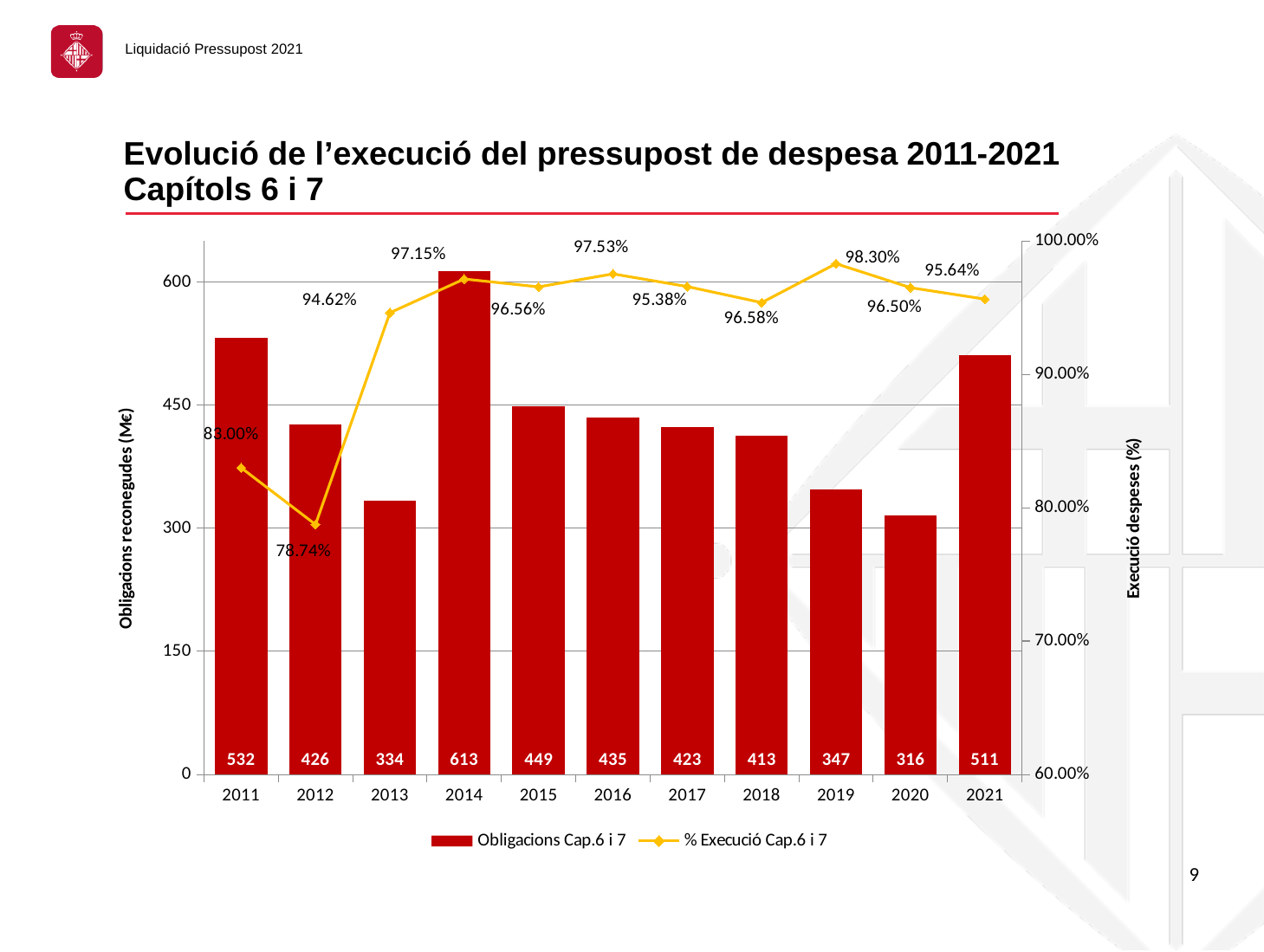
What is the label of the left vertical axis? Obligacions reconegudes (M€) Which year has the highest value of Obligacions Cap.6 i 7? 2014 Which year has the lowest value of Obligacions Cap.6 i 7? 2020 What is the difference in Obligacions Cap.6 i 7 between 2021 and 2020? 195 What is the value of Obligacions Cap.6 i 7 for 2014? 613 Which year has the lowest % Execució Cap.6 i 7? 2012 What kind of chart is used for the Obligacions Cap.6 i 7 series? bar chart How many series does the legend list? 2 What is the % Execució Cap.6 i 7 for 2019? 98.30% What is the % Execució Cap.6 i 7 for 2012? 78.74% Which is larger, the Obligacions Cap.6 i 7 for 2015 or for 2016? 2015 How many years are shown on the x axis? 11